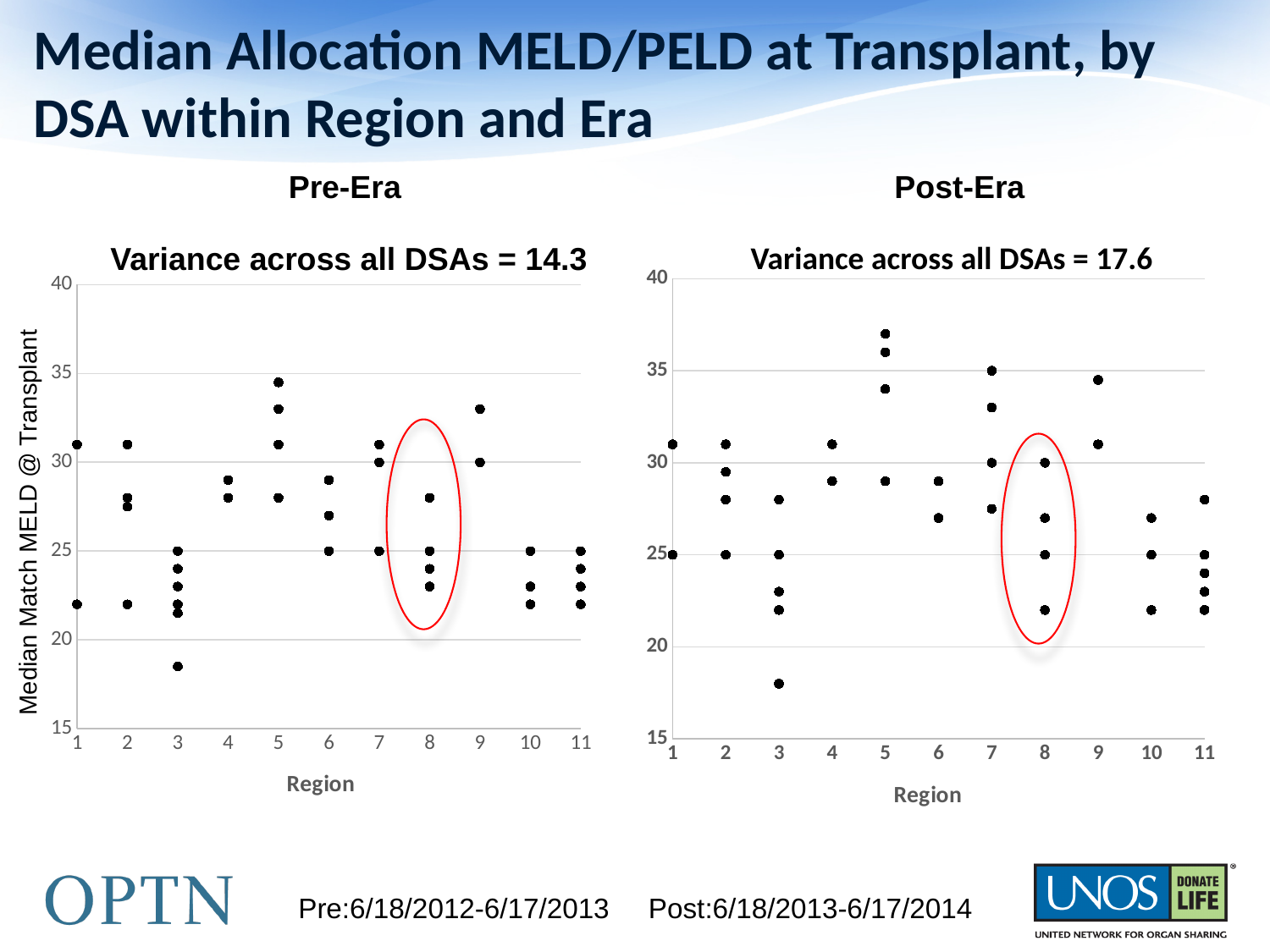
How many regions are shown on the x axis of the Post-Era chart? 11 In the Post-Era chart, which region contains the lowest plotted point? 3 In the Pre-Era chart, is the lowest point for region 3 greater or less than 20? less In the Pre-Era chart, is the highest point for region 9 greater or less than 30? greater Which region is circled in red on both charts? 8 By how much does the variance across all DSAs in the Post-Era chart exceed that in the Pre-Era chart? 3.3 What kind of chart is the Pre-Era chart? scatter chart In the Pre-Era chart, what is the variance across all DSAs stated in the chart title? 14.3 In the Post-Era chart, is the highest point for region 5 greater or less than 35? greater In the Pre-Era chart, which region contains the lowest plotted point? 3 In the Post-Era chart, which region contains the highest plotted point? 5 In the Post-Era chart, what is the variance across all DSAs stated in the chart title? 17.6